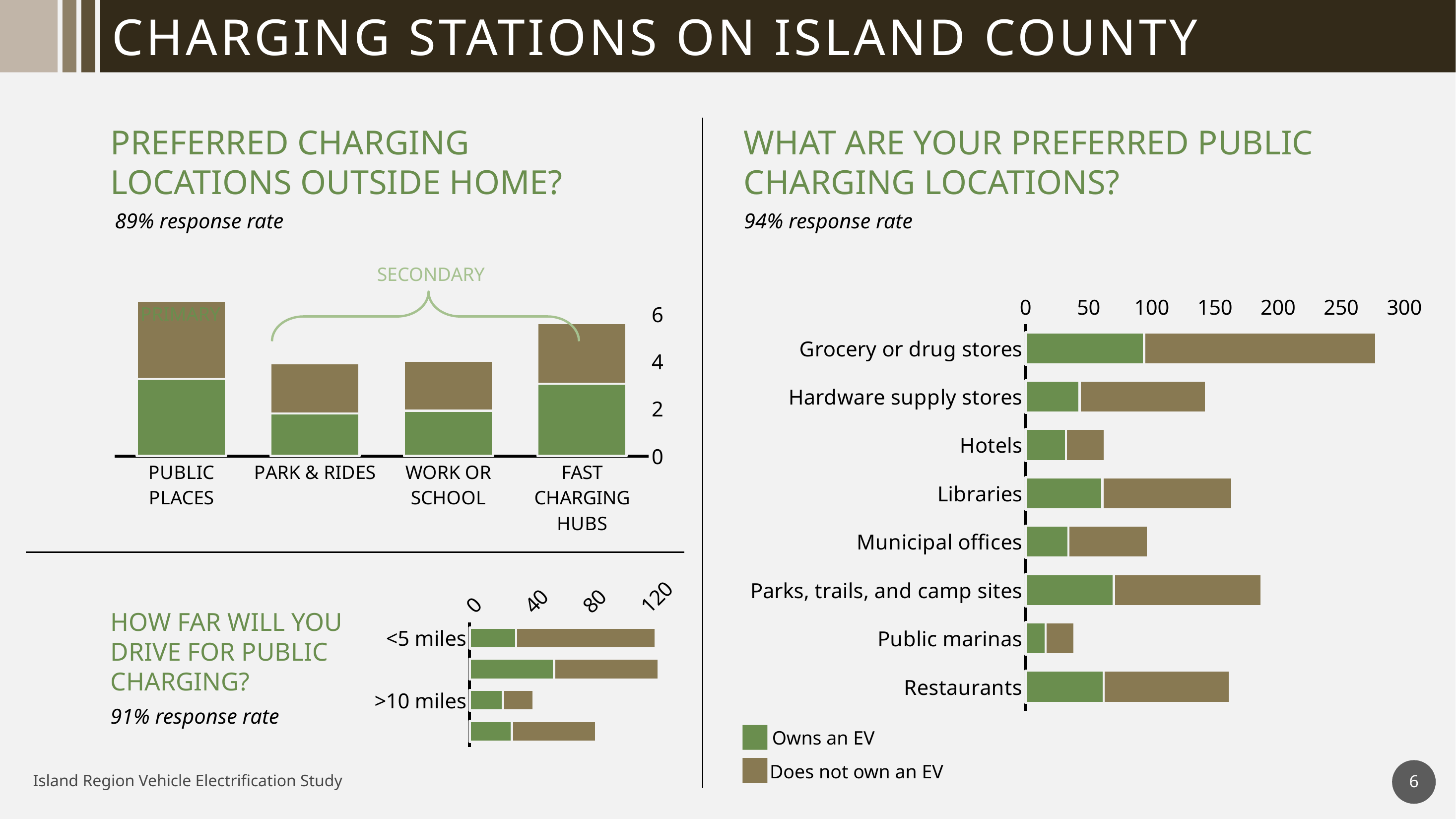
In the 'What are your preferred public charging locations?' chart, is the total value for Hotels greater or less than 100? less How many categories are shown in the 'Preferred charging locations outside home?' chart? 4 In the 'How far will you drive for public charging?' chart, which has a larger total: <5 miles or >10 miles? <5 miles How many locations are listed in the 'What are your preferred public charging locations?' chart? 8 In the 'What are your preferred public charging locations?' chart, which has a larger total: Hardware supply stores or Hotels? Hardware supply stores In the 'What are your preferred public charging locations?' chart, which location has the longest bar? Grocery or drug stores In the 'Preferred charging locations outside home?' chart, which category has the tallest bar? Public Places In the 'What are your preferred public charging locations?' chart, which colour represents 'Owns an EV'? Green In the 'What are your preferred public charging locations?' chart, which location has the shortest bar? Public marinas How many series does the legend of the 'What are your preferred public charging locations?' chart list? 2 In the 'What are your preferred public charging locations?' chart, is the total value for Grocery or drug stores greater or less than 250? greater In the 'Preferred charging locations outside home?' chart, is the total value for Fast Charging Hubs greater or less than 4? greater